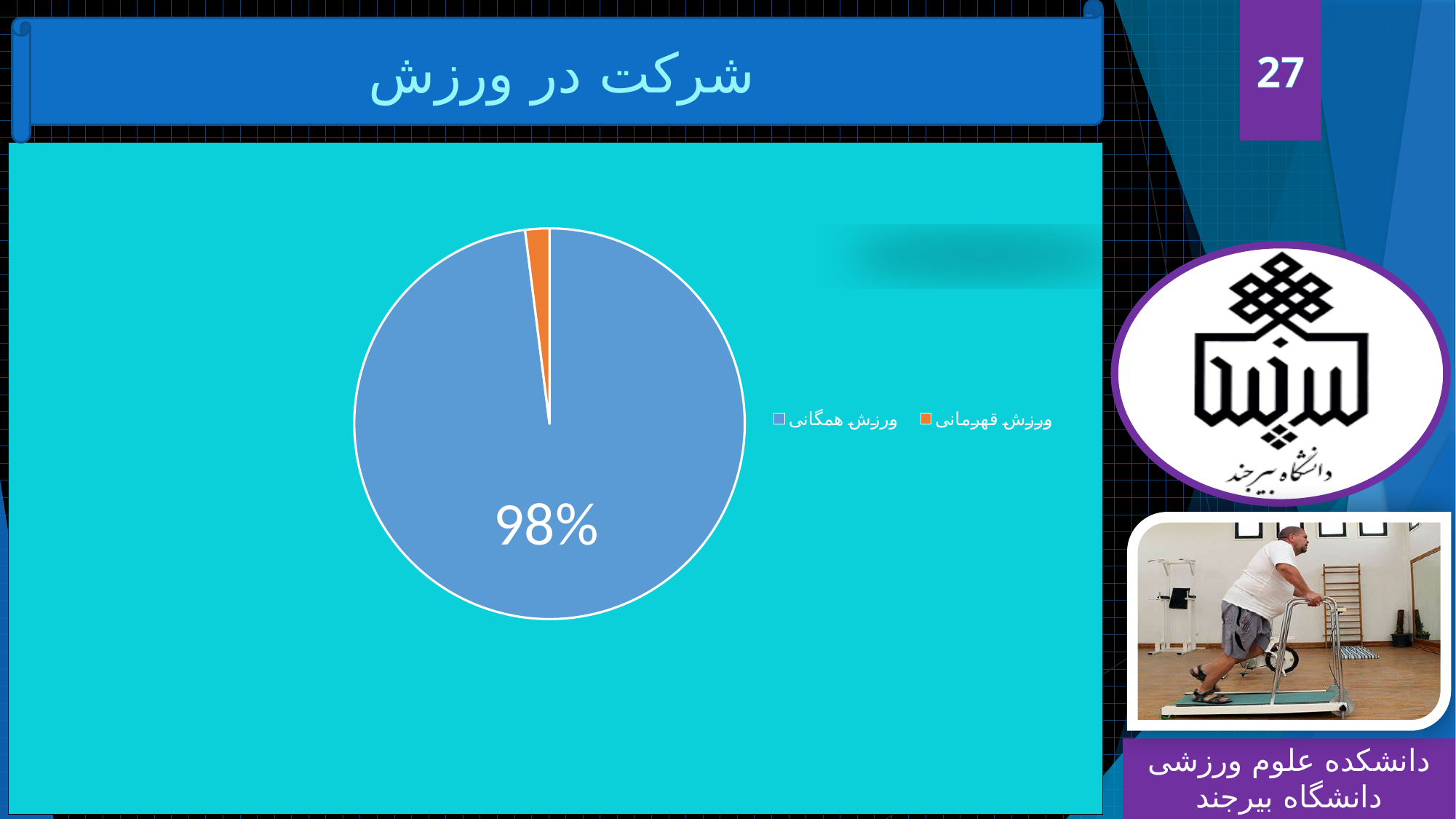
What colour is the ورزش همگانی slice in the pie chart? blue What colour is the ورزش قهرمانی slice in the pie chart? orange What share of the pie does the ورزش همگانی slice represent? 98% How many slices does the pie chart have? 2 Which category has the smallest slice in the pie chart? ورزش قهرمانی Which slice is larger in the pie chart, ورزش همگانی or ورزش قهرمانی? ورزش همگانی What percentage is printed on the pie chart for ورزش همگانی? 98% What kind of chart is shown on the slide? pie chart Which category has the largest slice in the pie chart? ورزش همگانی How many entries does the legend of the pie chart list? 2